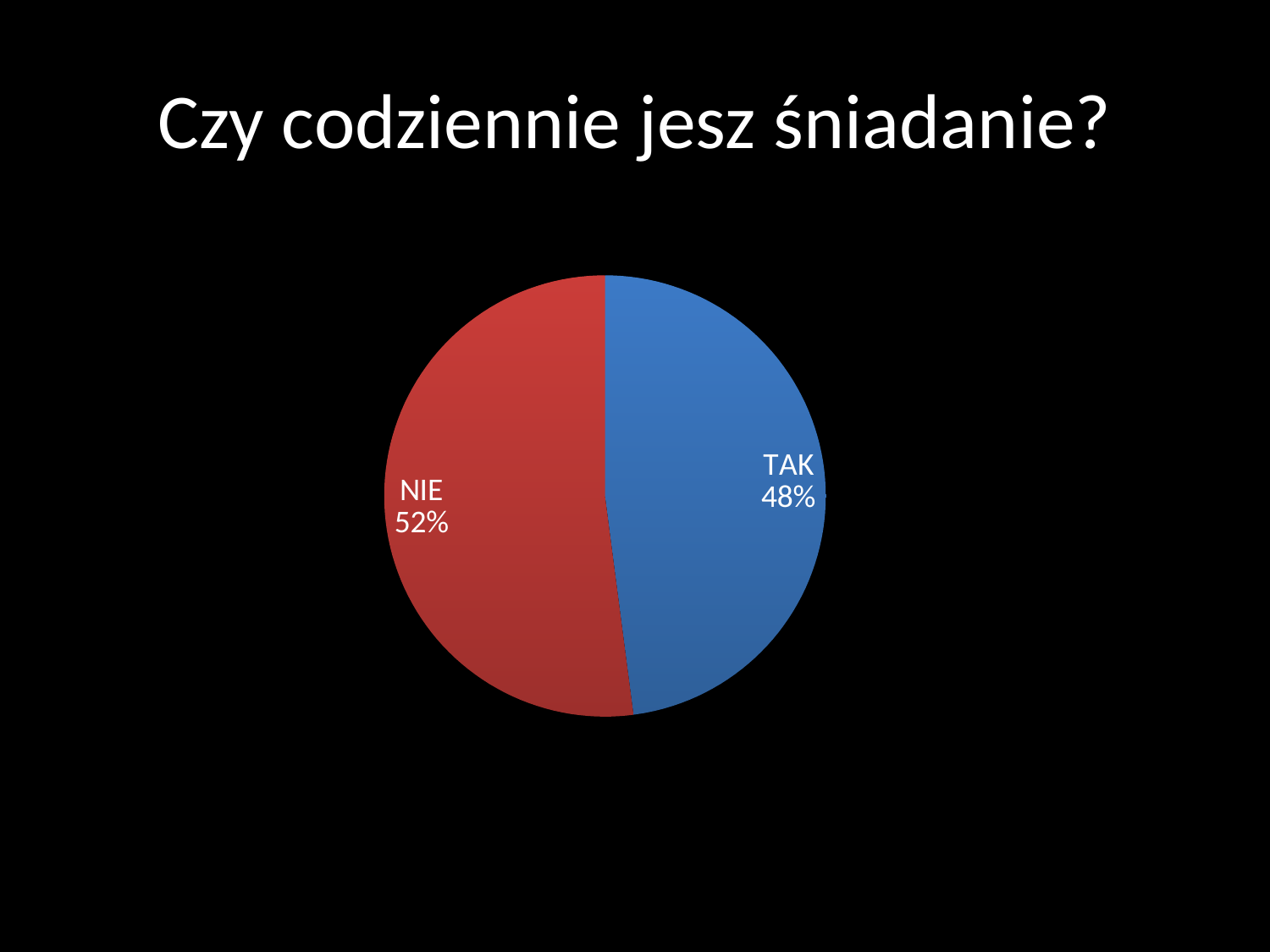
What colour is the NIE slice? red What percentage of the pie is labelled NIE? 52% Which slice is the smallest? TAK What share of the pie does the TAK slice represent? 48% What type of chart is shown on the slide? pie chart What is the difference between the NIE share and the TAK share? 4% What is the total of the two slices' percentages? 100% Which slice is the largest? NIE How many slices does the pie chart have? 2 What percentage of the pie is labelled TAK? 48% What is the title of the slide above the chart? Czy codziennie jesz śniadanie? Which is larger, the TAK slice or the NIE slice? NIE